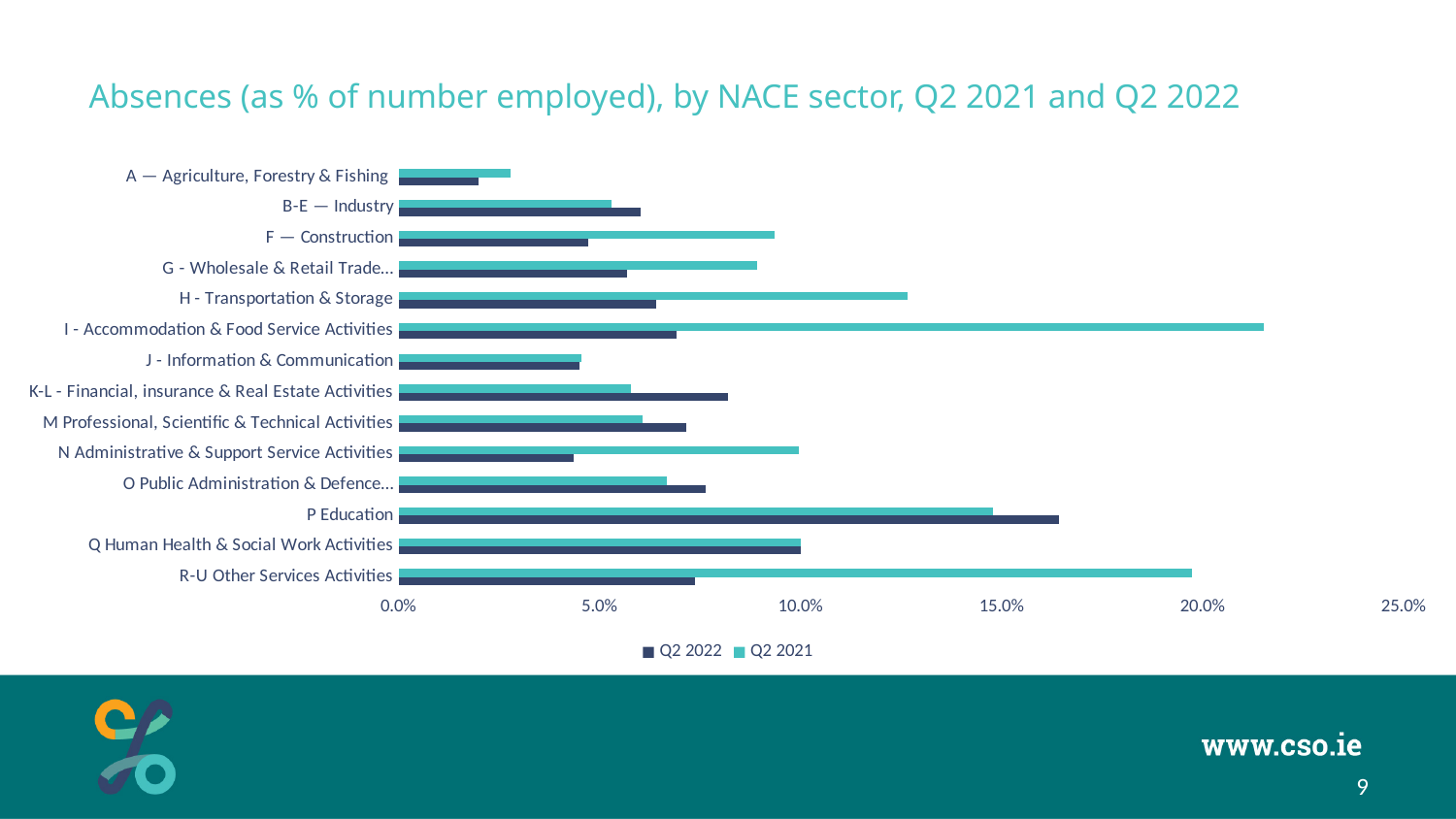
Which sector has the highest absence rate for Q2 2021? I - Accommodation & Food Service Activities How many NACE sectors are plotted on the chart? 14 What kind of chart is shown on the slide? Bar chart For K-L - Financial, insurance & Real Estate Activities, which is larger: the Q2 2021 value or the Q2 2022 value? Q2 2022 Is the Q2 2021 value for I - Accommodation & Food Service Activities greater or less than 20.0%? greater How many series does the legend list? 2 Which sector has the lowest absence rate for Q2 2021? A — Agriculture, Forestry & Fishing Is the Q2 2022 value for N Administrative & Support Service Activities greater or less than 5.0%? less For F — Construction, which is larger: the Q2 2021 value or the Q2 2022 value? Q2 2021 Is the Q2 2021 value for H - Transportation & Storage greater or less than 10.0%? greater Which sector has the highest absence rate for Q2 2022? P Education